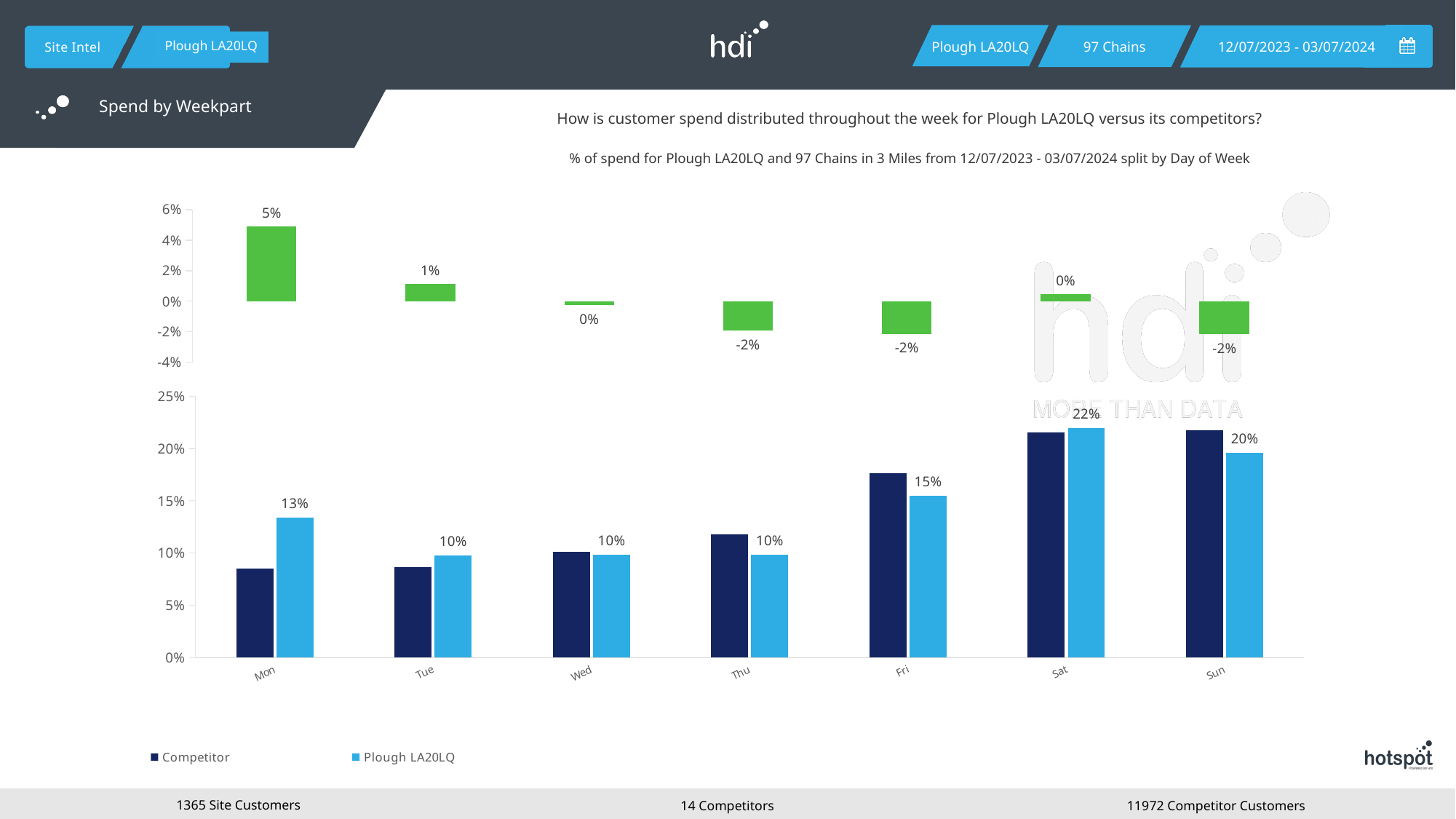
In the bottom chart, what is the value for Plough LA20LQ on Mon? 13% In the bottom chart, what is the value for Plough LA20LQ on Fri? 15% In the bottom chart, which is larger on Sun: the Competitor bar or the Plough LA20LQ bar? Competitor In the top chart, what is the value shown for Mon? 5% In the bottom chart, on which day is the Plough LA20LQ value highest? Sat In the bottom chart, is the Competitor value for Mon greater or less than 10%? less In the top chart, which day has the highest value? Mon In the bottom chart, what is the value for Plough LA20LQ on Sat? 22% In the bottom chart, is the Competitor value for Sat greater or less than 20%? greater In the top chart, what is the value shown for Thu? -2% How many series does the legend of the bottom chart list? 2 In the bottom chart, what is the difference between the Plough LA20LQ values for Sat and Mon? 9%